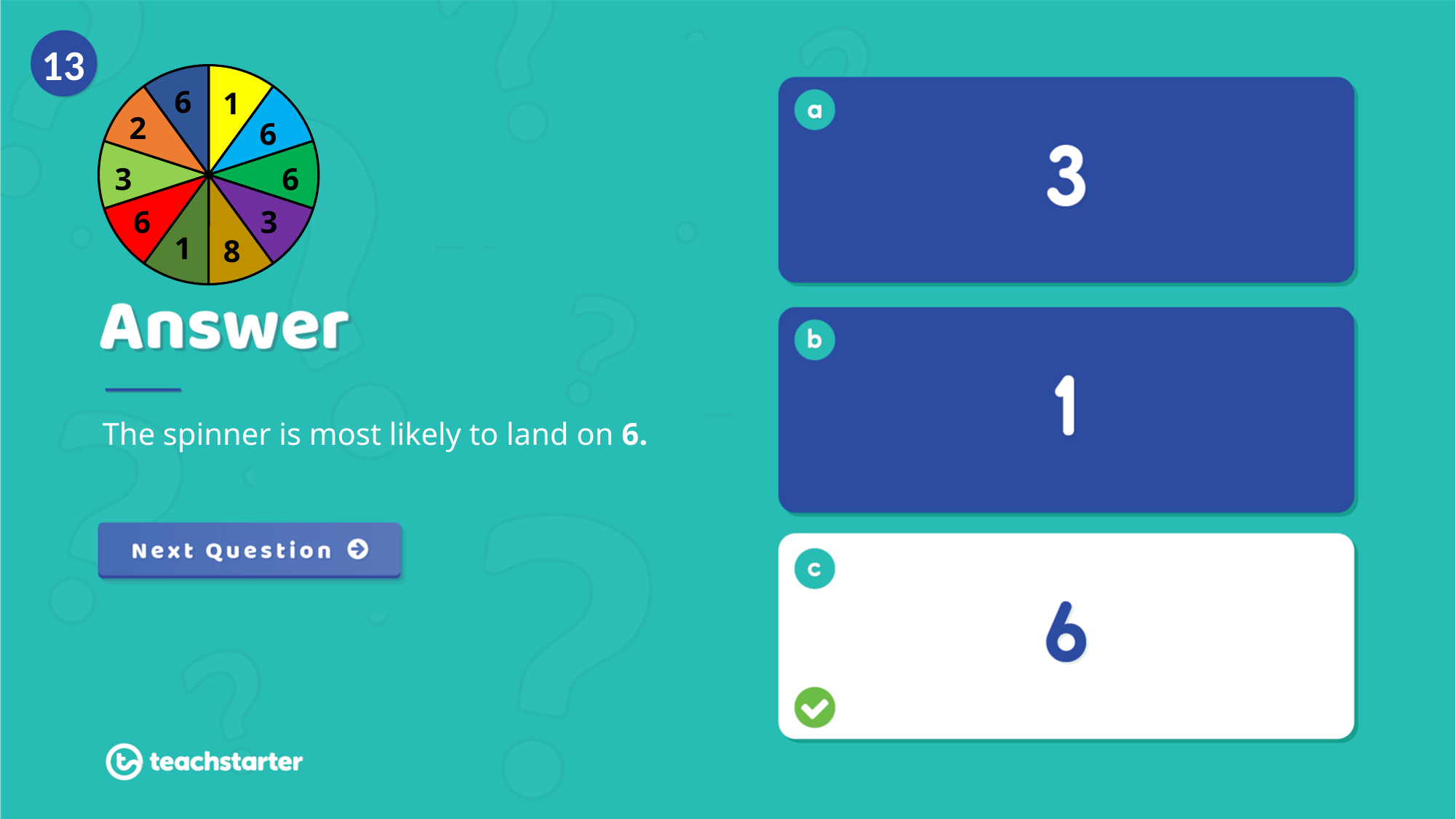
How many sectors of the spinner are labeled 3? 2 Which number appears on the most sectors of the spinner? 6 How many sectors does the spinner have? 10 What number is on the purple sector of the spinner? 3 What is the smallest number printed on the spinner? 1 How many sectors of the spinner are labeled 6? 4 What number is on the red sector of the spinner? 6 What number is on the dark yellow (gold) sector of the spinner? 8 What is the largest number printed on the spinner? 8 What number is on the orange sector of the spinner? 2 What number is on the yellow sector of the spinner? 1